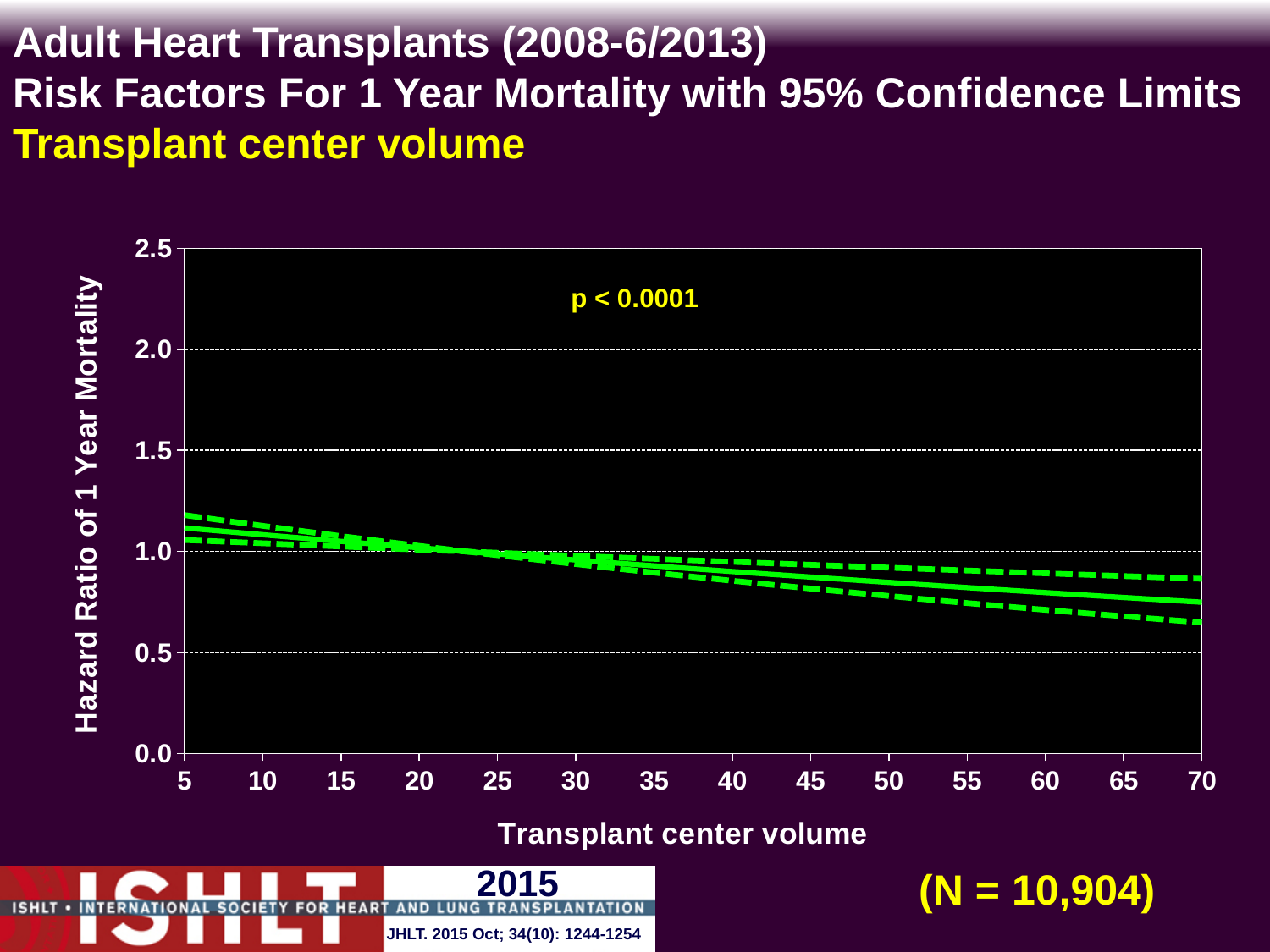
Is the hazard ratio at a transplant center volume of 70 greater or less than 1.0? less How many tick labels are shown on the x axis of the chart? 14 What kind of chart is shown on the slide? line chart At which transplant center volume shown on the x axis is the hazard ratio highest? 5 Which has the larger hazard ratio: a transplant center volume of 10 or a volume of 60? 10 What p-value is printed on the chart? p < 0.0001 Is the hazard ratio at a transplant center volume of 5 greater or less than 1.5? less Does the hazard ratio of 1 year mortality rise or fall as transplant center volume increases from 5 to 70? fall What sample size (N) is shown on the slide? N = 10,904 Is the hazard ratio at a transplant center volume of 5 greater or less than 1.0? greater At which transplant center volume shown on the x axis is the hazard ratio lowest? 70